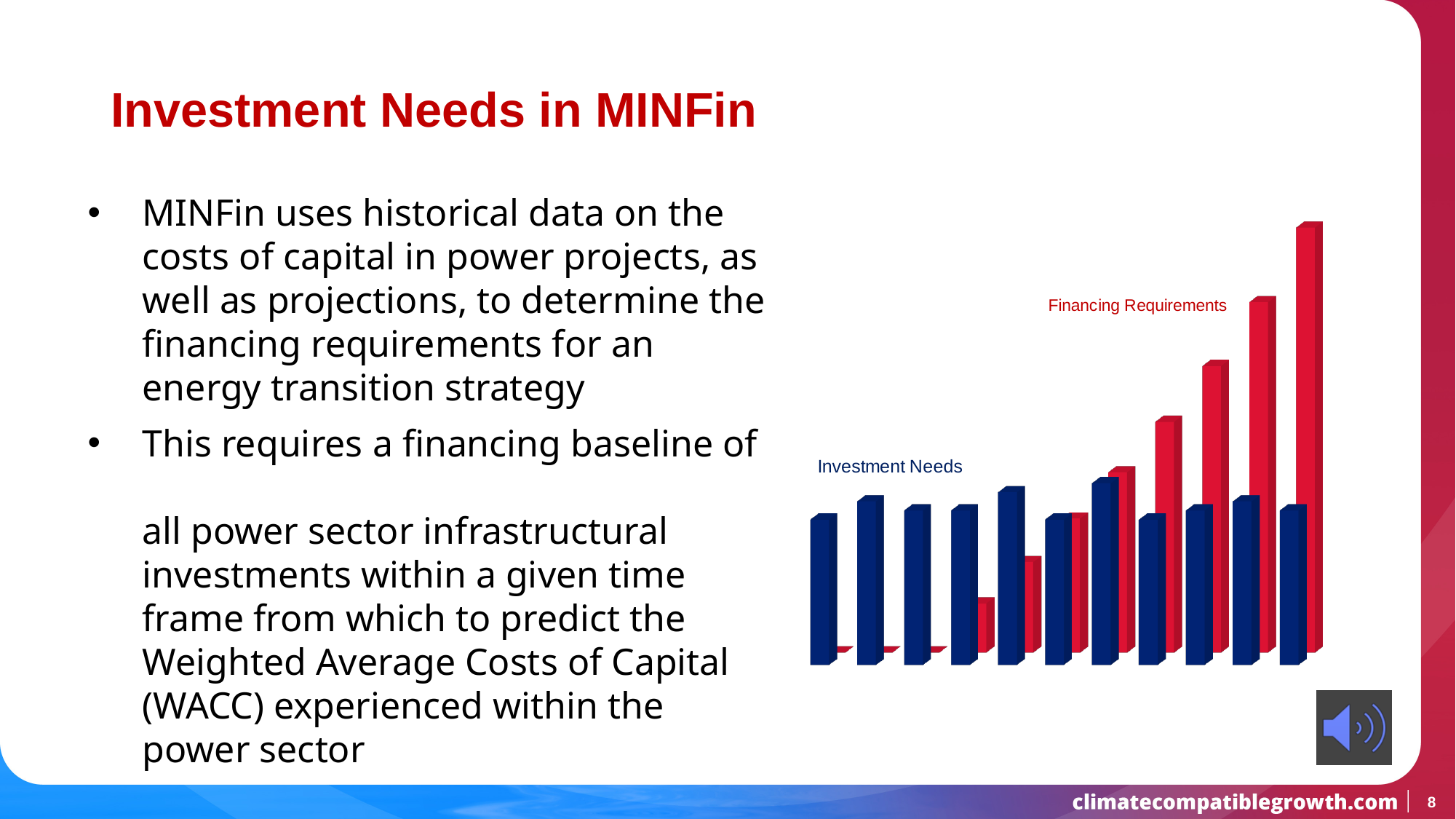
In the leftmost pair of bars, which series is larger: Investment Needs or Financing Requirements? Investment Needs What are the names of the two series shown in the chart? Investment Needs and Financing Requirements Which series contains the tallest bar in the chart? Financing Requirements Which colour represents the Financing Requirements series? red In the rightmost pair of bars, which series is larger: Investment Needs or Financing Requirements? Financing Requirements How many blue Investment Needs bars are plotted in the chart? 11 What kind of chart is shown on the slide? bar chart How many data series does the chart show? 2 Which series has the lowest bar in the chart? Financing Requirements Do the Financing Requirements values rise or fall from left to right across the chart? rise